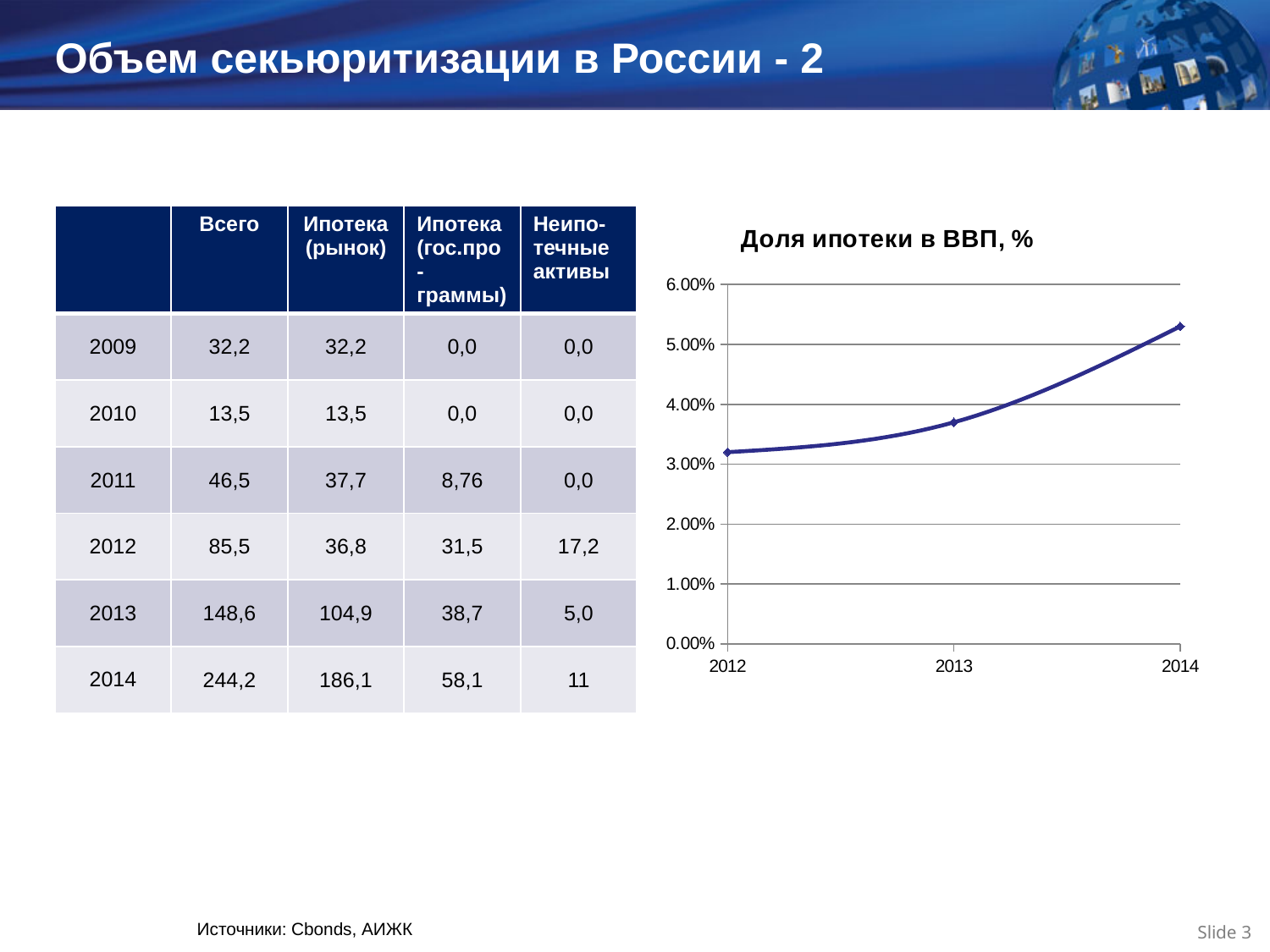
Which year has the larger value in the chart, 2013 or 2014? 2014 How many years are plotted on the x axis of the chart? 3 What kind of chart is shown on the slide? line chart Is the value for 2012 greater or less than 4.00%? less What is the title of the chart on the slide? Доля ипотеки в ВВП, % What is the highest tick value shown on the y axis of the chart? 6.00% Do the values in the chart rise or fall from 2012 to 2014? rise Which year has the highest value in the chart? 2014 Which year has the lowest value in the chart? 2012 Is the value for 2013 greater or less than 4.00%? less Is the value for 2013 greater or less than 3.00%? greater